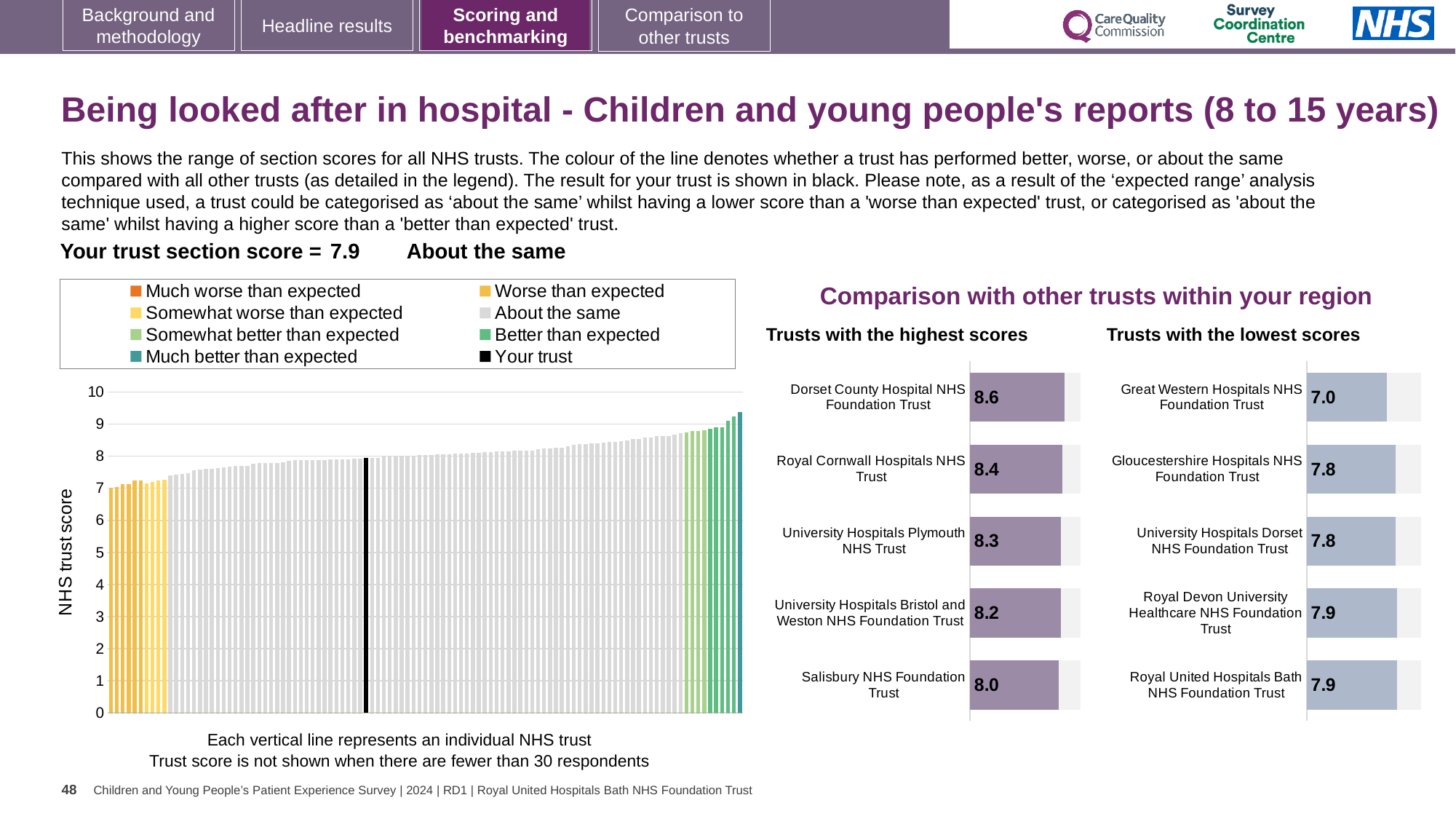
In the large chart on the left, do the trust scores rise or fall from left to right? Rise In the 'Trusts with the lowest scores' chart, what is the difference between the scores of Gloucestershire Hospitals NHS Foundation Trust and Great Western Hospitals NHS Foundation Trust? 0.8 In the 'Trusts with the highest scores' chart, what is the score for Salisbury NHS Foundation Trust? 8.0 In the 'Trusts with the lowest scores' chart, which trust has the lowest score? Great Western Hospitals NHS Foundation Trust In the 'Trusts with the highest scores' chart, which trust has the highest score? Dorset County Hospital NHS Foundation Trust In the 'Trusts with the lowest scores' chart, what is the score for Great Western Hospitals NHS Foundation Trust? 7.0 In the 'Trusts with the lowest scores' chart, which has the larger score: Royal Devon University Healthcare NHS Foundation Trust or Great Western Hospitals NHS Foundation Trust? Royal Devon University Healthcare NHS Foundation Trust How many entries does the legend above the large chart on the left list? 8 In the 'Trusts with the highest scores' chart, what is the difference between the scores of Dorset County Hospital NHS Foundation Trust and Salisbury NHS Foundation Trust? 0.6 How many trusts are shown in the 'Trusts with the highest scores' chart? 5 In the 'Trusts with the highest scores' chart, what is the score for Dorset County Hospital NHS Foundation Trust? 8.6 What kind of chart is the large chart on the left showing NHS trust scores? Bar chart